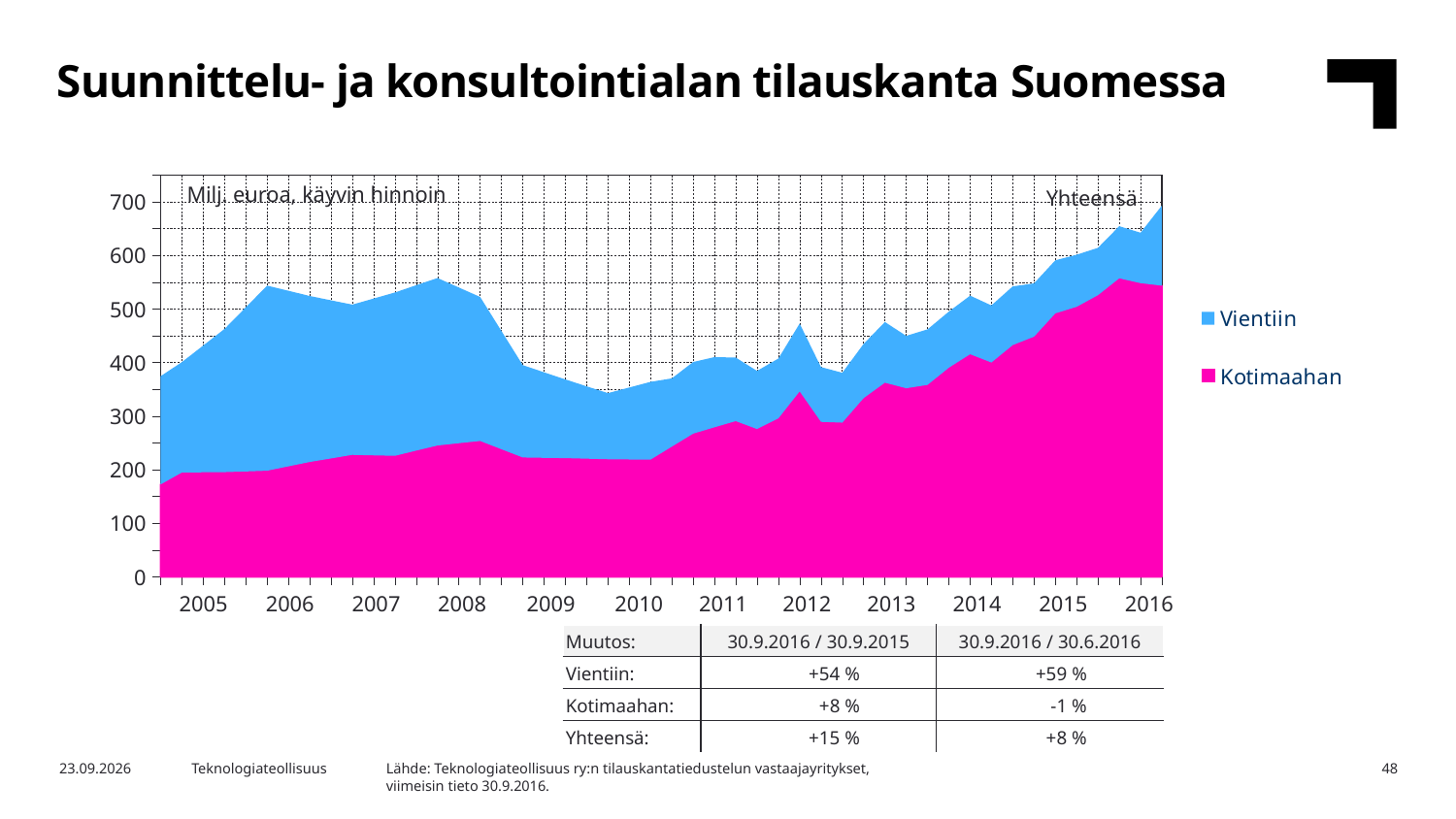
What type of chart is shown on the slide? area chart Is the total (Yhteensä) at 2008 greater or less than 500? greater Is the total (Yhteensä) at 2010 greater or less than 400? less Is the value for Kotimaahan at 2016 greater or less than 500? greater How many years are labelled on the x axis? 12 How many series does the legend list? 2 Does the value for Kotimaahan rise or fall from 2012 to 2016? rise Which two series are listed in the legend? Vientiin and Kotimaahan What unit is stated in the label at the top left of the chart? Milj. euroa, käyvin hinnoin At 2016, which series is larger, Vientiin or Kotimaahan? Kotimaahan